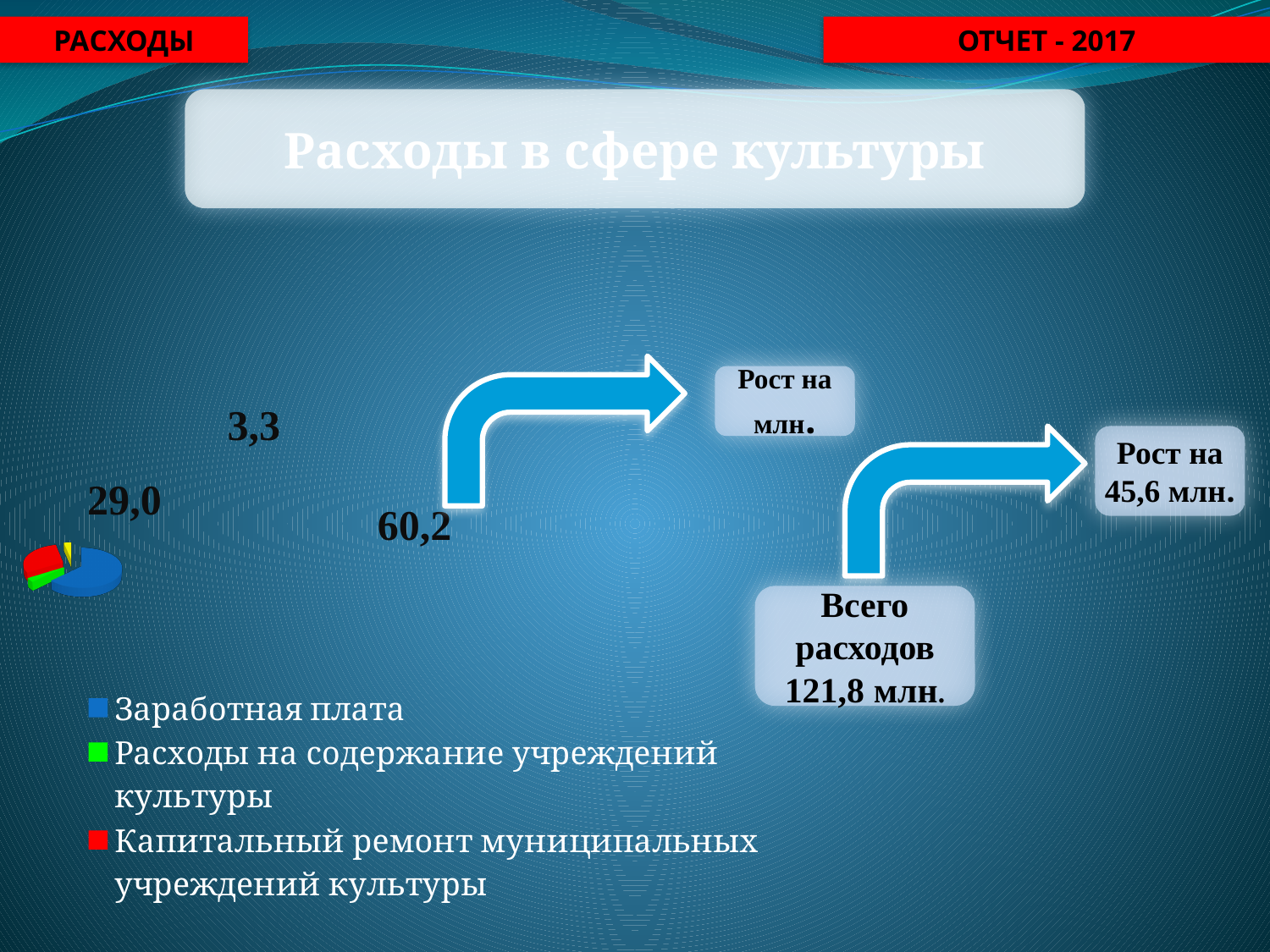
Which is larger in the pie chart: Заработная плата or Капитальный ремонт муниципальных учреждений культуры? Заработная плата What kind of chart is shown on the slide? pie chart What colour represents Заработная плата in the pie chart legend? blue What is the value shown for Заработная плата in the pie chart? 60,2 How many entries does the legend of the pie chart list? 3 What is the title of the slide containing the pie chart? Расходы в сфере культуры What is the value shown for Капитальный ремонт муниципальных учреждений культуры in the pie chart? 29,0 Which category has the largest slice in the pie chart? Заработная плата